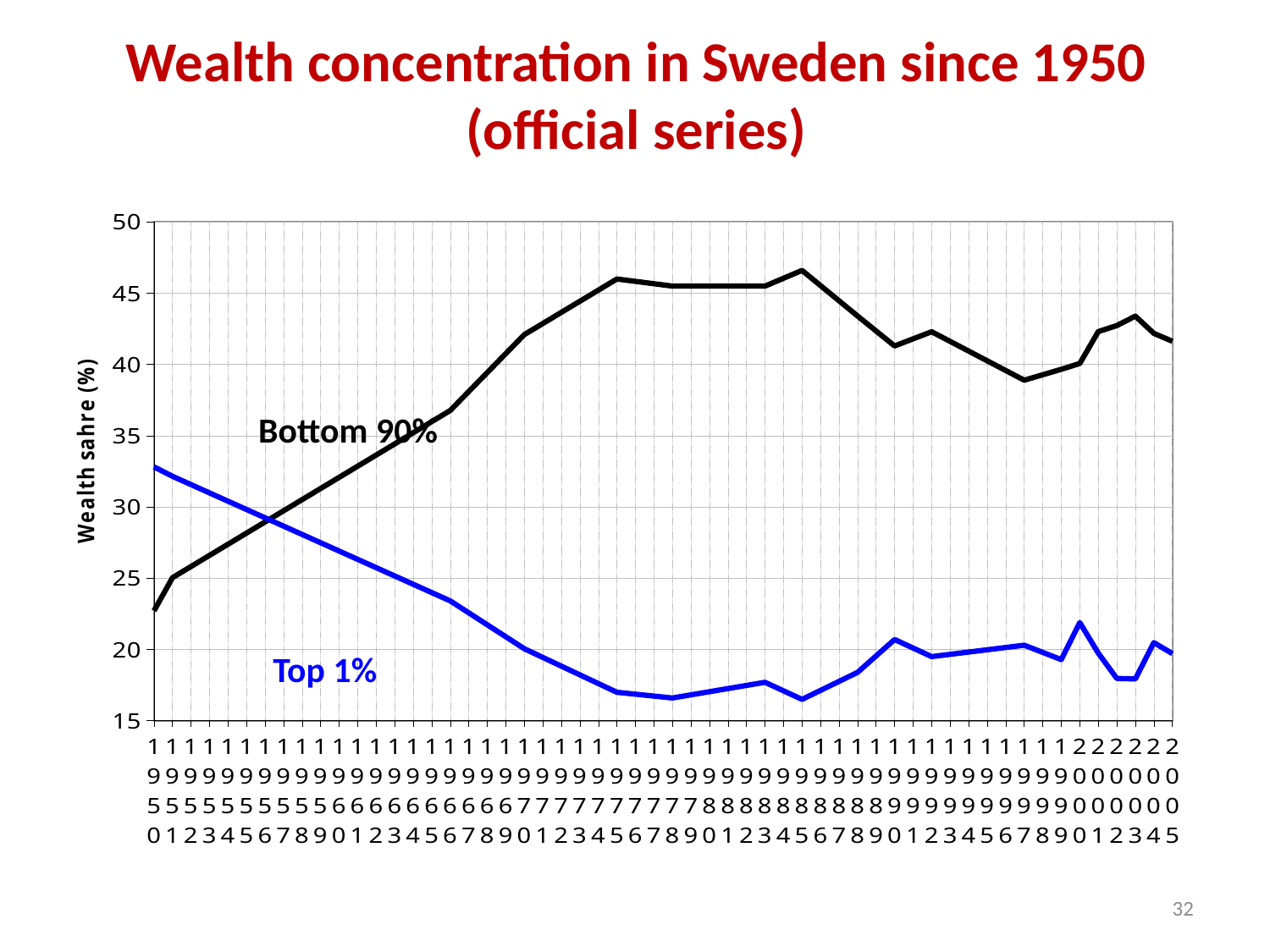
Is the value for Bottom 90% in 1975 greater or less than 45? greater In 1950, which series has the larger value, Top 1% or Bottom 90%? Top 1% Is the value for Top 1% in 1975 greater or less than 20? less What colour is the line for the Top 1% series? blue Does the Top 1% series rise or fall between 1950 and 1975? fall How many series are plotted on the chart? 2 Is the value for Top 1% in 1950 greater or less than 30? greater What is the title of the chart on the slide? Wealth concentration in Sweden since 1950 (official series) What kind of chart is shown on the slide? line chart In which year is the Top 1% series at its highest? 1950